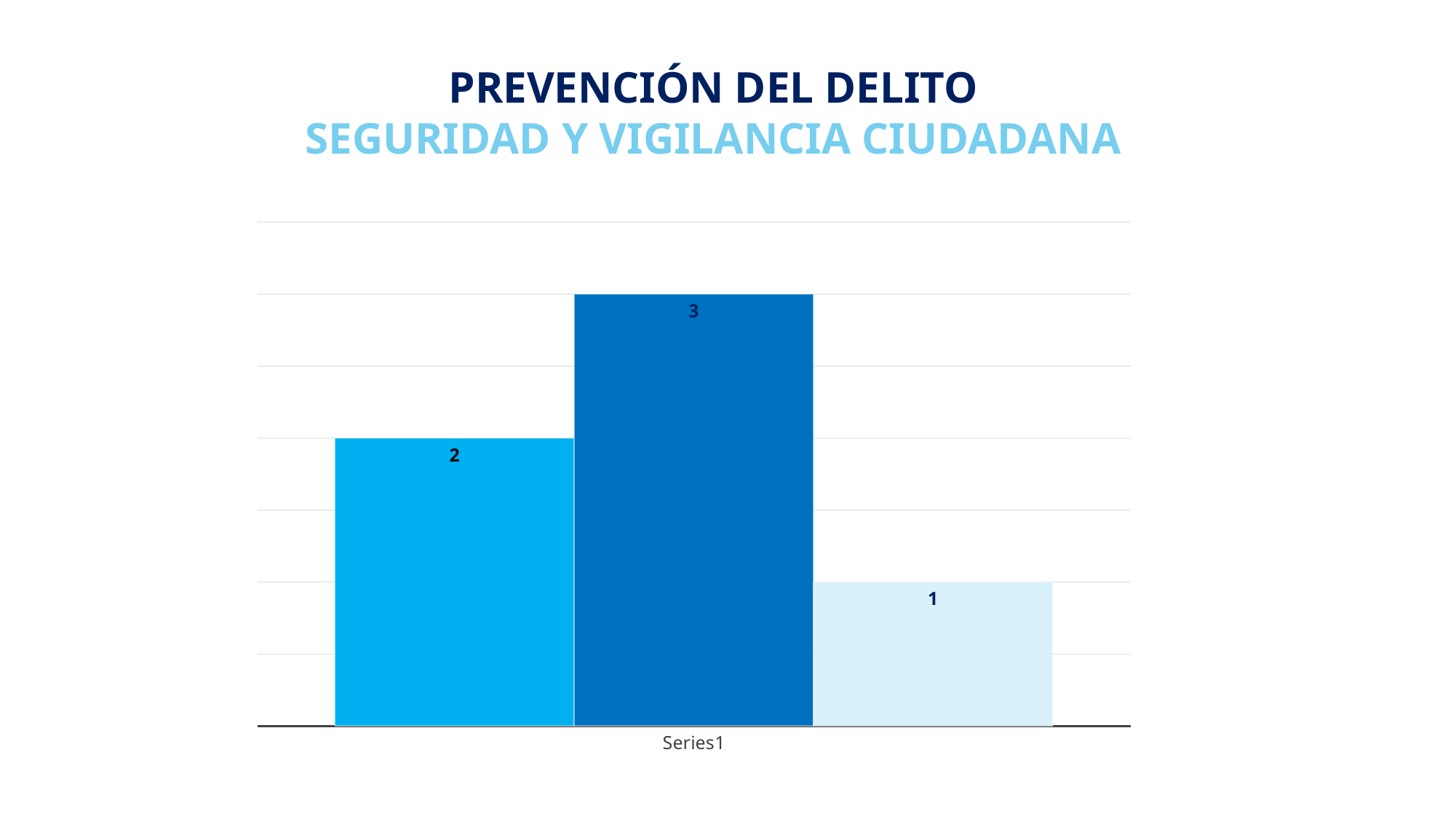
What is the value of the tallest bar in the chart? 3 How many bars are plotted in the chart? 3 What is the value of the rightmost (light blue) bar in the chart? 1 What is the title text shown above the chart? PREVENCIÓN DEL DELITO SEGURIDAD Y VIGILANCIA CIUDADANA Which bar is larger, the leftmost bar or the rightmost bar? the leftmost bar What is the value of the leftmost bar in the chart? 2 What is the difference between the leftmost bar and the middle bar? 1 What is the category label shown on the x axis of the chart? Series1 What kind of chart is shown on the slide? bar chart What is the value of the shortest bar in the chart? 1 What is the difference between the middle bar and the rightmost bar? 2 What is the value of the middle (dark blue) bar in the chart? 3